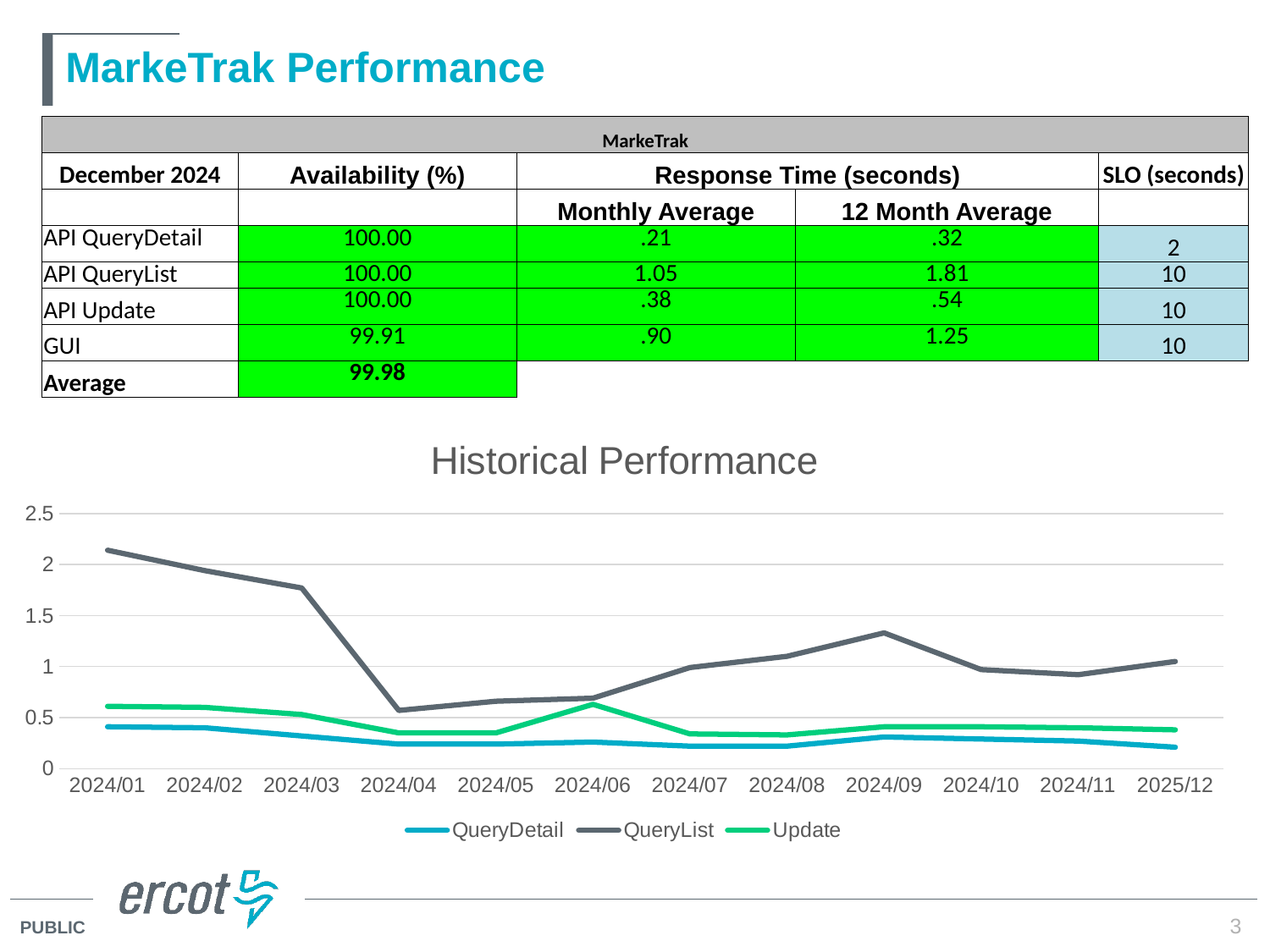
What kind of chart is the Historical Performance chart? line chart In the Historical Performance chart, is the QueryList value for 2024/04 greater or less than 1? less In the Historical Performance chart, is the QueryDetail value for 2024/01 greater or less than 0.5? less In the Historical Performance chart, is the Update value for 2024/06 greater or less than 0.5? greater Which series are listed in the legend of the Historical Performance chart? QueryDetail, QueryList, Update How many months are plotted along the x axis of the Historical Performance chart? 12 What is the title of the line chart on the slide? Historical Performance In the Historical Performance chart, does the QueryList series rise or fall from 2024/01 to 2024/04? fall In the Historical Performance chart, which series has the lowest value at 2025/12? QueryDetail How many series does the legend of the Historical Performance chart list? 3 In the Historical Performance chart, which series has the highest value at 2024/09? QueryList